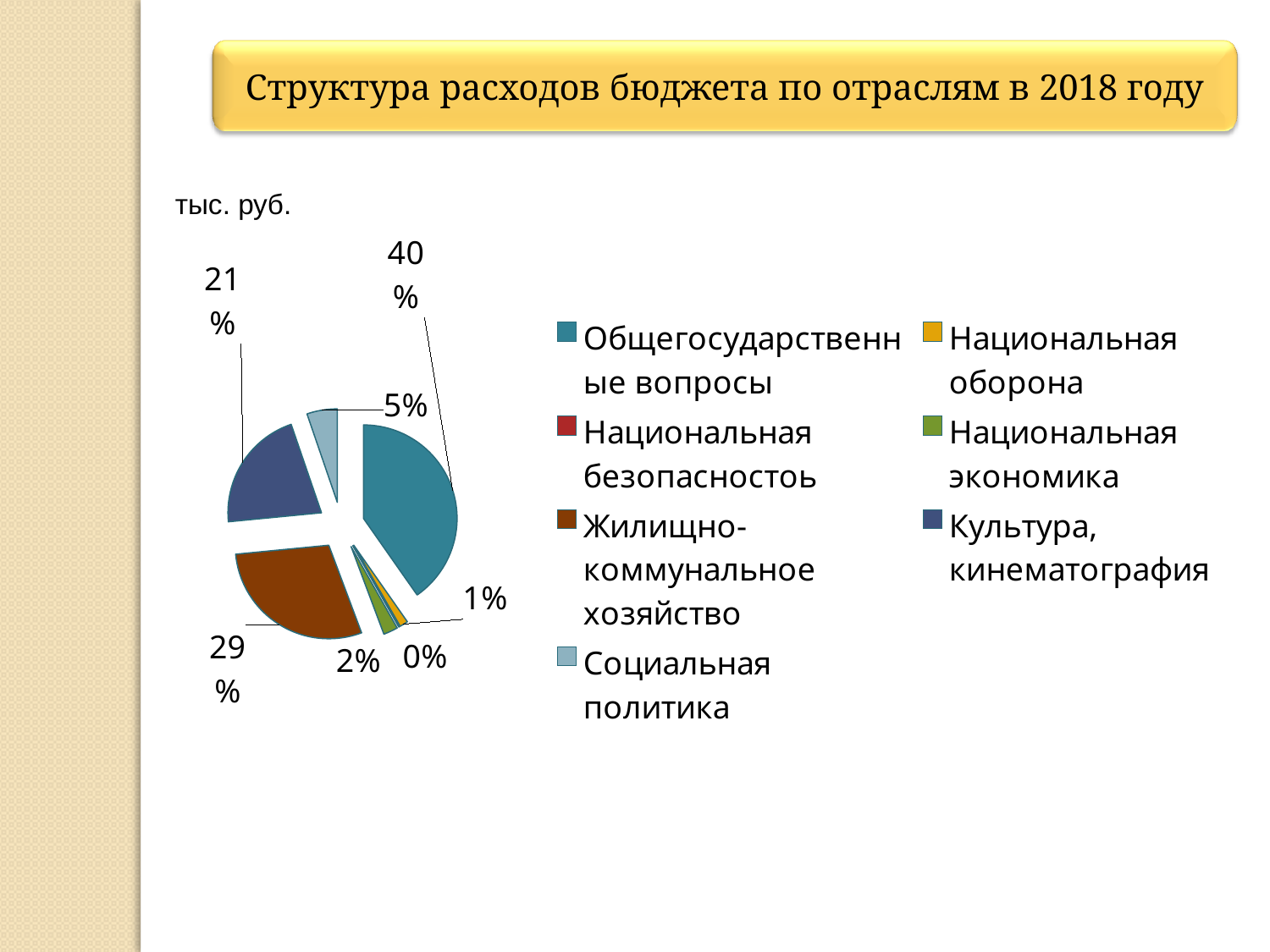
Which has a larger share: Культура, кинематография or Социальная политика? Культура, кинематография What share of the pie does Общегосударственные вопросы have? 40% What share of the pie does Культура, кинематография have? 21% What is the difference in percentage points between Общегосударственные вопросы and Жилищно-коммунальное хозяйство? 11 How many categories does the legend of the pie chart list? 7 What unit is written above the pie chart? тыс. руб. What is the title of the chart on the slide? Структура расходов бюджета по отраслям в 2018 году What share of the pie does Национальная экономика have? 2% What share of the pie does Социальная политика have? 5% What type of chart is shown on the slide? pie chart What share of the pie does Жилищно-коммунальное хозяйство have? 29% Which category has the largest share of the pie? Общегосударственные вопросы